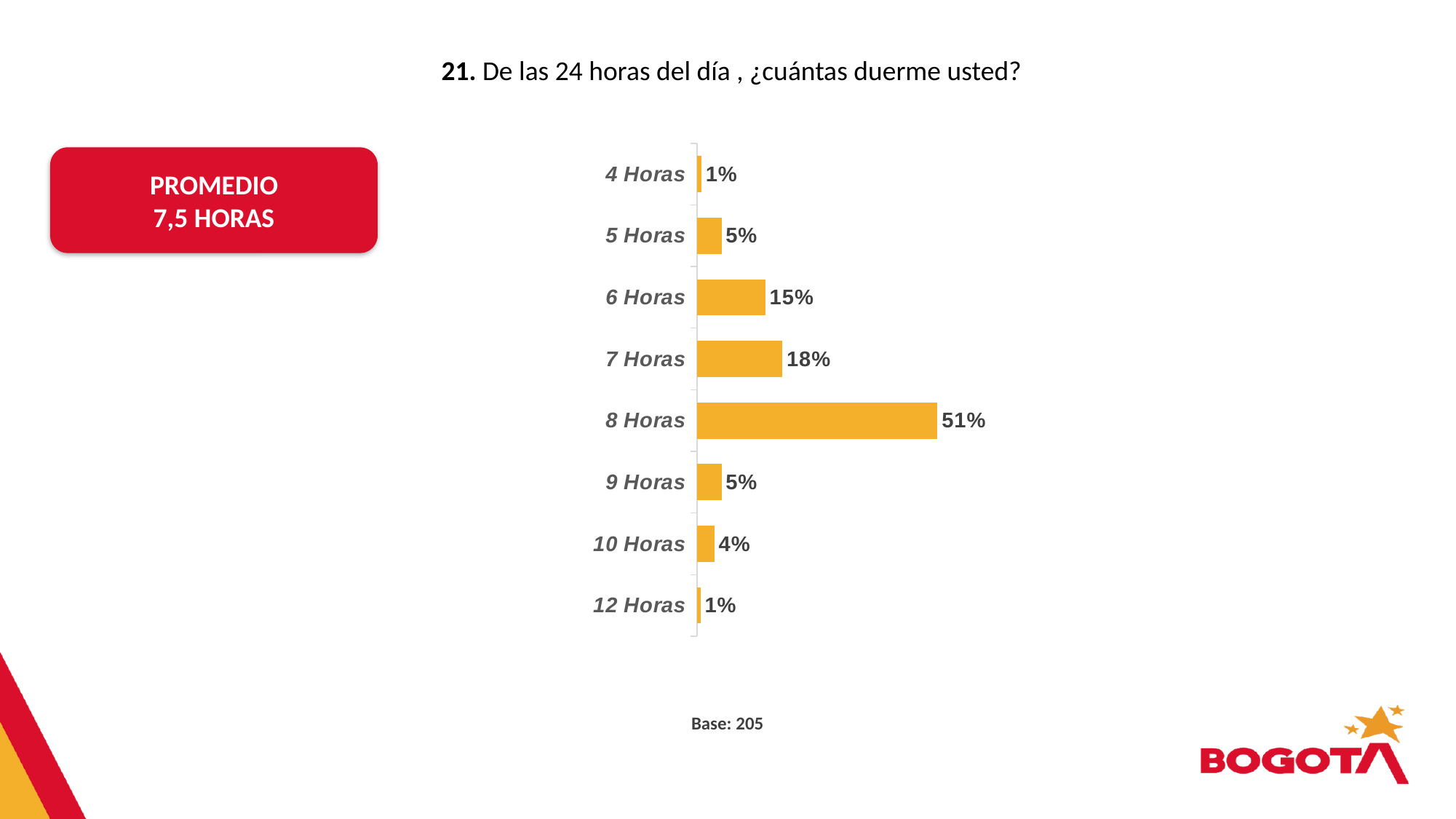
What is the base (number of respondents) shown below the chart? 205 What is the difference between the values for 7 Horas and 6 Horas? 3% What is the difference between the values for 8 Horas and 7 Horas? 33% What average number of hours is shown in the red box on the slide? 7,5 HORAS Which category has the highest value? 8 Horas What is the value shown for 6 Horas? 15% How many categories are shown in the chart? 8 What percentage is shown for 10 Horas? 4% What kind of chart is shown on the slide? Bar chart Do the values rise or fall from 4 Horas to 8 Horas? Rise Which is larger, the value for 5 Horas or the value for 6 Horas? 6 Horas What percentage of respondents sleep 8 Horas? 51%